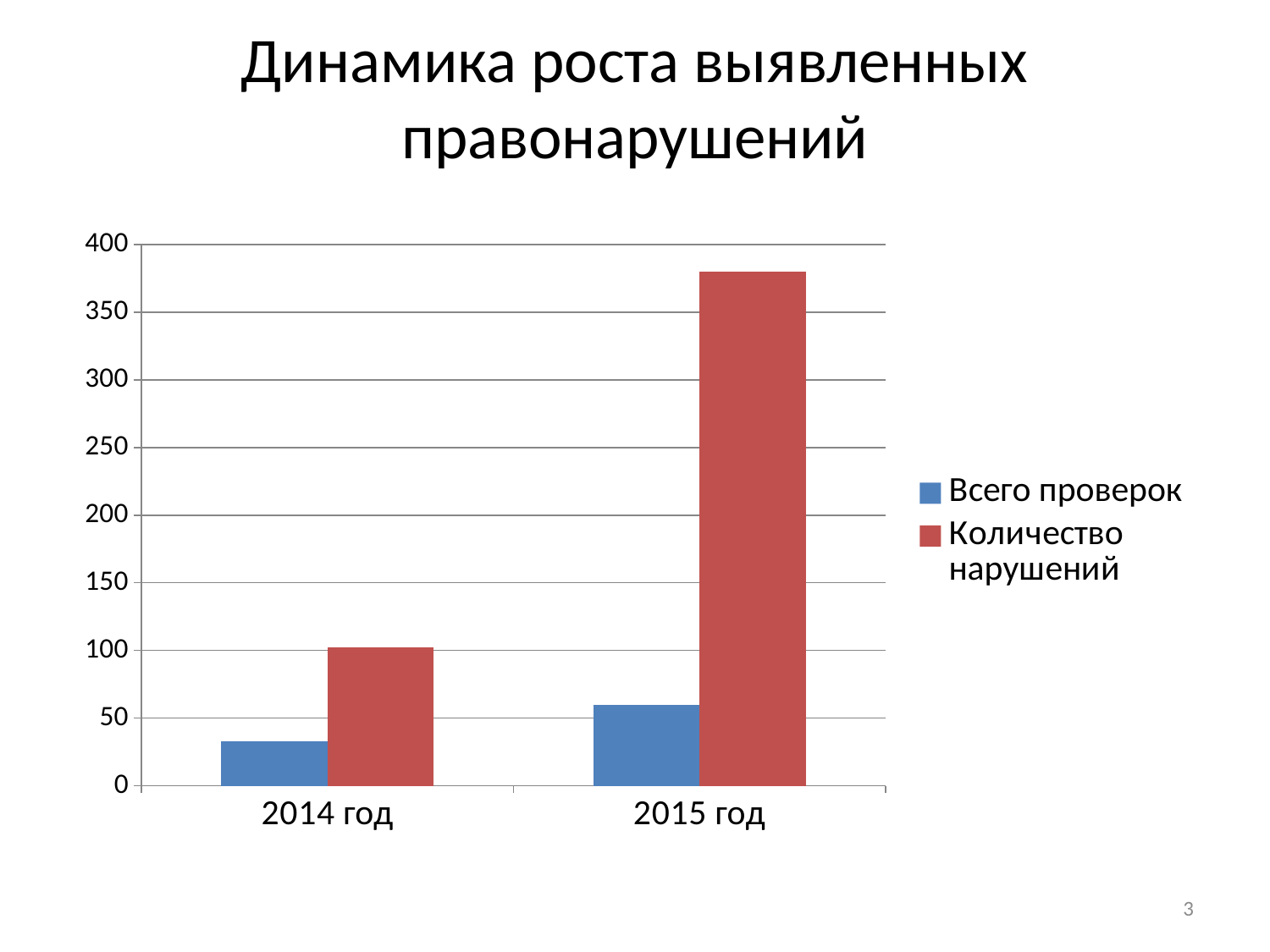
Which is larger in 2015 год: Всего проверок or Количество нарушений? Количество нарушений Do the values for Всего проверок rise or fall from 2014 год to 2015 год? rise Is the value for Всего проверок in 2014 год greater or less than 50? less Which series is shown in red? Количество нарушений How many series does the legend list? 2 Which year has the higher value for Количество нарушений? 2015 год Is the value for Всего проверок in 2015 год greater or less than 100? less Is the value for Количество нарушений in 2015 год greater or less than 350? greater How many categories are shown on the x axis? 2 What kind of chart is shown on the slide? bar chart What is the title of the chart? Динамика роста выявленных правонарушений